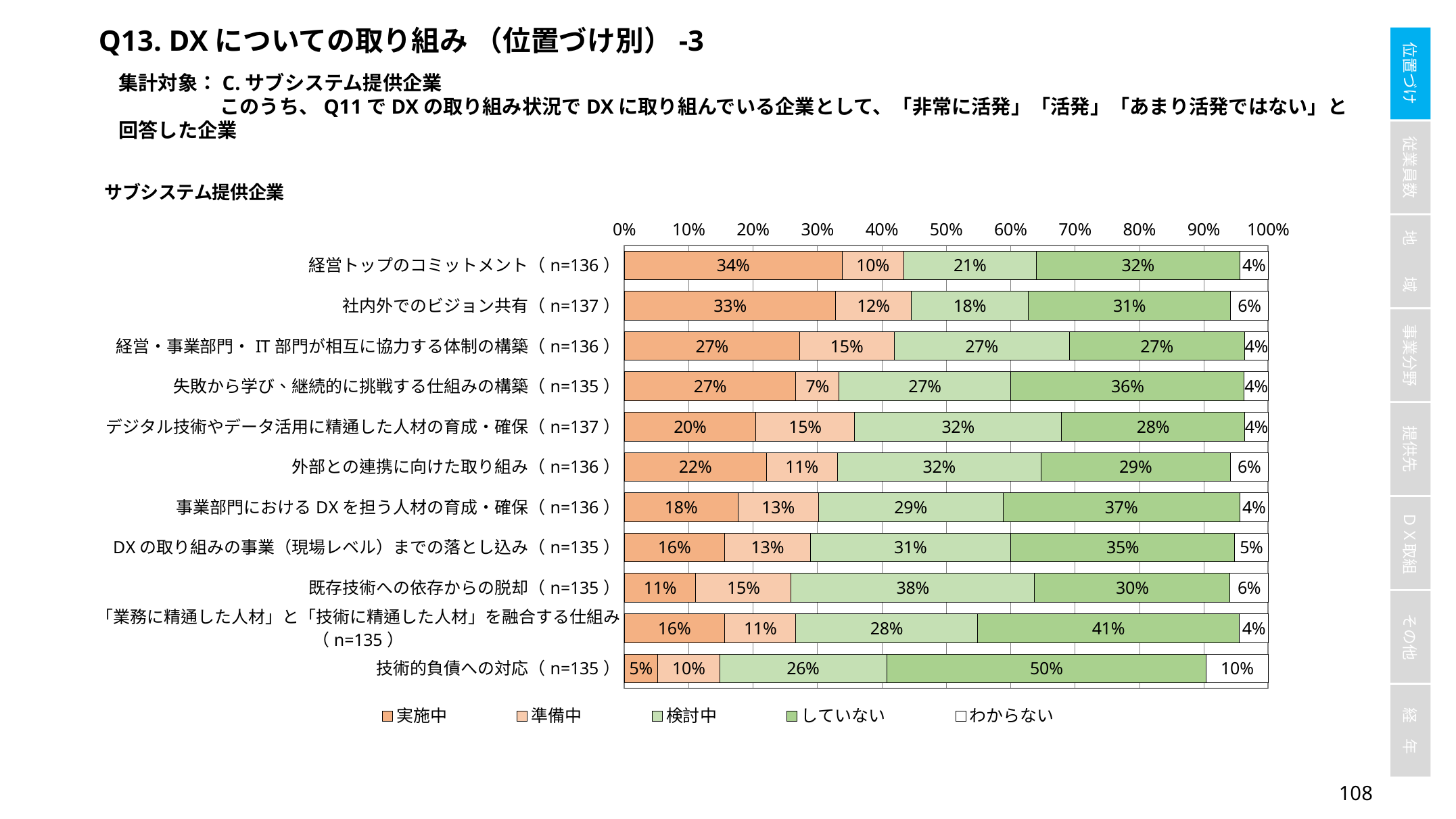
What is the legend label of the darkest green series? していない What is the 検討中 value for 既存技術への依存からの脱却? 38% What is the 実施中 value for 経営トップのコミットメント? 34% Which category has the lowest 実施中 value? 技術的負債への対応 What is the difference between the 実施中 values for 社内外でのビジョン共有 and 外部との連携に向けた取り組み? 11% What type of chart is shown on the slide? Stacked bar chart What is the していない value for 技術的負債への対応? 50% How many series does the legend list? 5 Which category has the highest していない value? 技術的負債への対応 Which is larger: the 準備中 value for 失敗から学び、継続的に挑戦する仕組みの構築 or for デジタル技術やデータ活用に精通した人材の育成・確保? デジタル技術やデータ活用に精通した人材の育成・確保 How many categories (bars) are plotted in the chart? 11 Which category has the highest 実施中 value? 経営トップのコミットメント